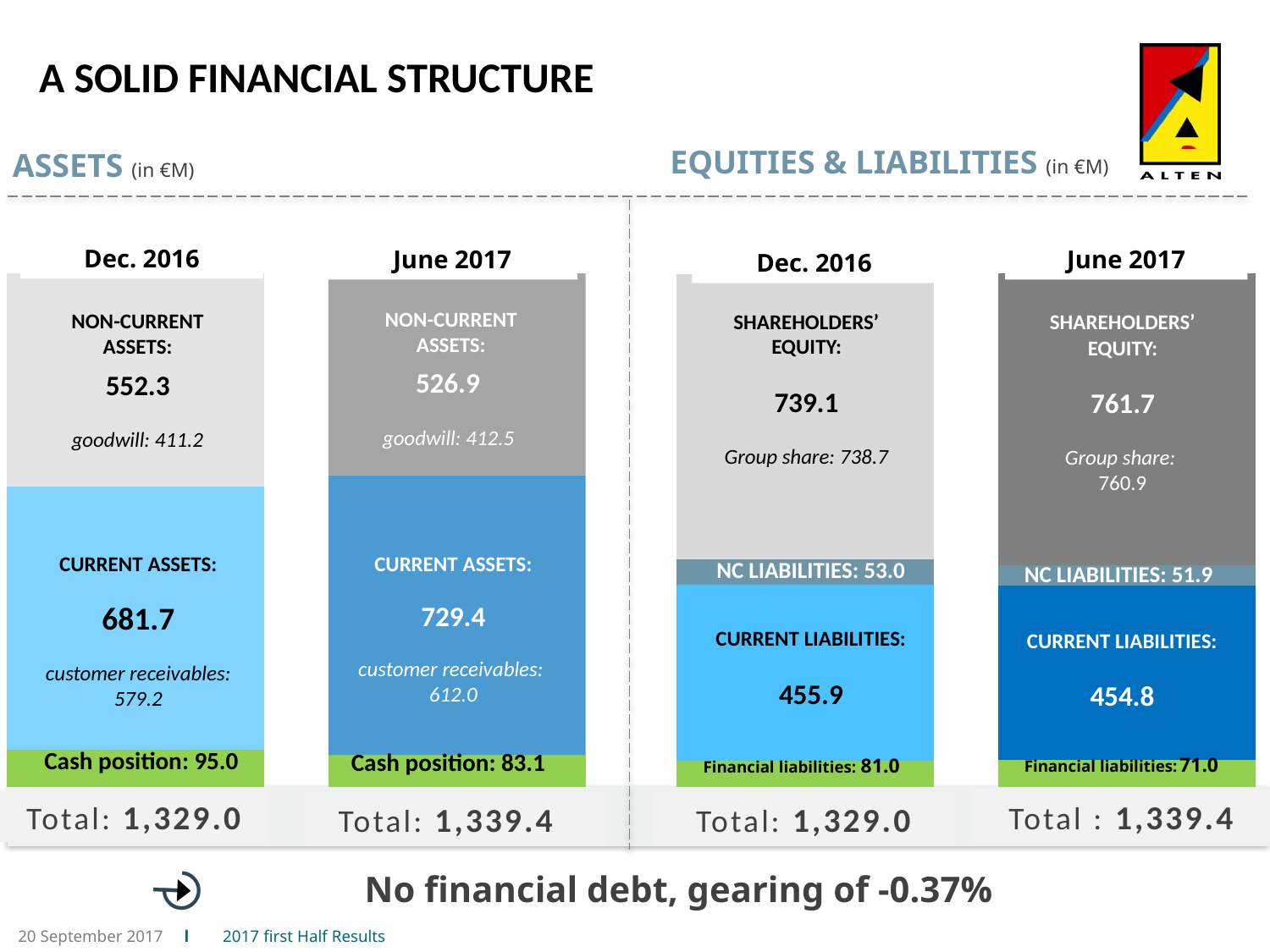
In the EQUITIES & LIABILITIES chart, did shareholders' equity rise or fall from Dec. 2016 to June 2017? rise What kind of chart is used to show the ASSETS on the slide? stacked bar chart In the ASSETS chart, what is the cash position for June 2017? 83.1 In the ASSETS chart, which period has the larger cash position, Dec. 2016 or June 2017? Dec. 2016 In the ASSETS chart, what is the total for June 2017? 1,339.4 In the ASSETS chart, what is the customer receivables figure for June 2017? 612.0 In the EQUITIES & LIABILITIES chart, what are the NC liabilities for Dec. 2016? 53.0 In the EQUITIES & LIABILITIES chart, what is the difference between current liabilities in Dec. 2016 and June 2017? 1.1 In the ASSETS chart, what is the value of non-current assets for Dec. 2016? 552.3 In the ASSETS chart, by how much did current assets change from Dec. 2016 to June 2017? 47.7 In the EQUITIES & LIABILITIES chart, what is the shareholders' equity for June 2017? 761.7 In the EQUITIES & LIABILITIES chart, what are the financial liabilities for June 2017? 71.0